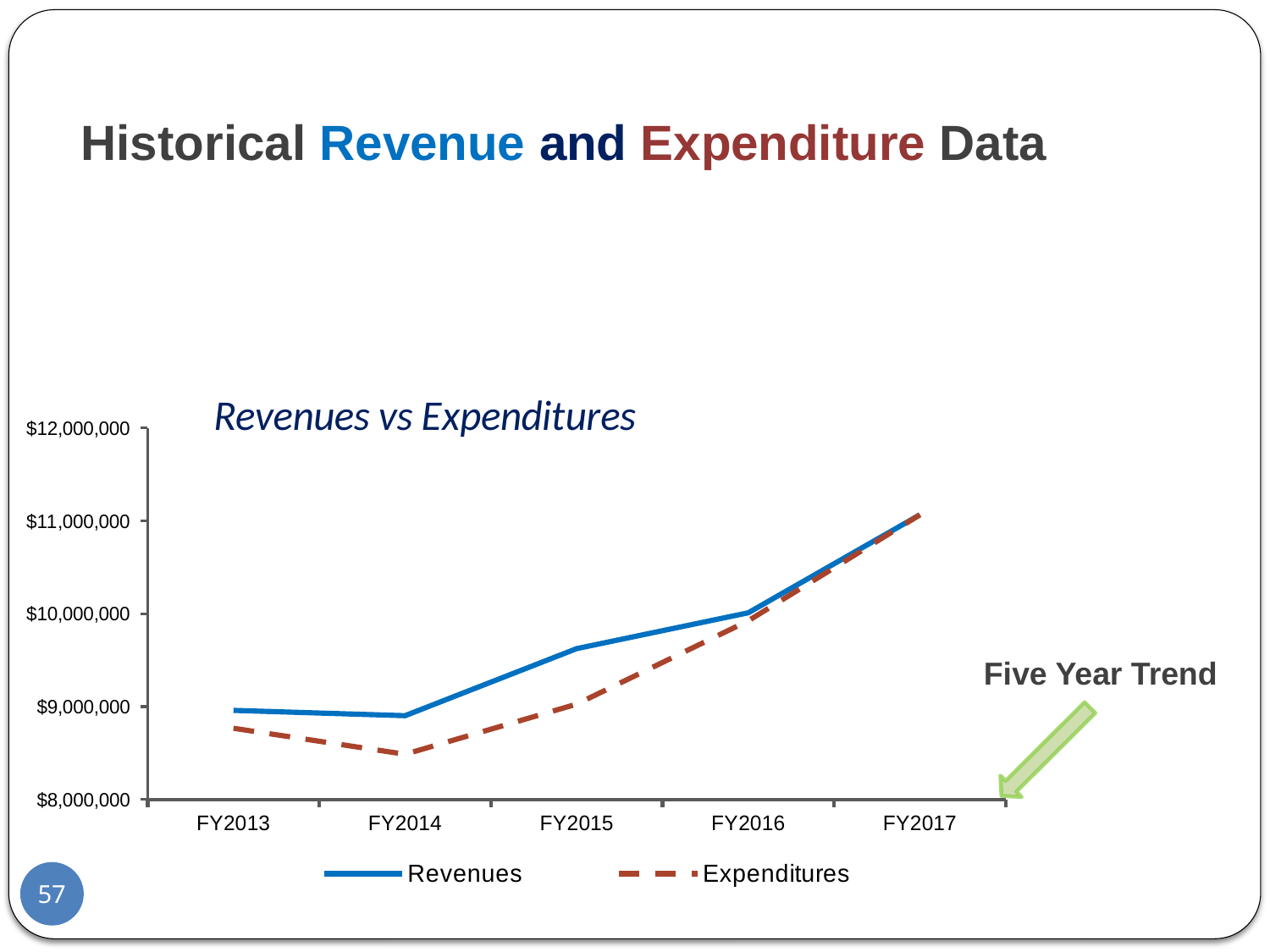
How many fiscal years are plotted on the x axis? 5 What kind of chart is shown on the slide? line chart What is the title of the chart? Revenues vs Expenditures Do Expenditures rise or fall from FY2014 to FY2017? rise Is the value for Revenues in FY2015 greater or less than $9,000,000? greater How many series does the legend list? 2 Is the value for Revenues in FY2017 greater or less than $10,000,000? greater Which series is drawn with a dashed line? Expenditures Is the value for Expenditures in FY2014 greater or less than $9,000,000? less In which fiscal year are Revenues highest? FY2017 In which fiscal year are Expenditures lowest? FY2014 In FY2015, which is larger, Revenues or Expenditures? Revenues